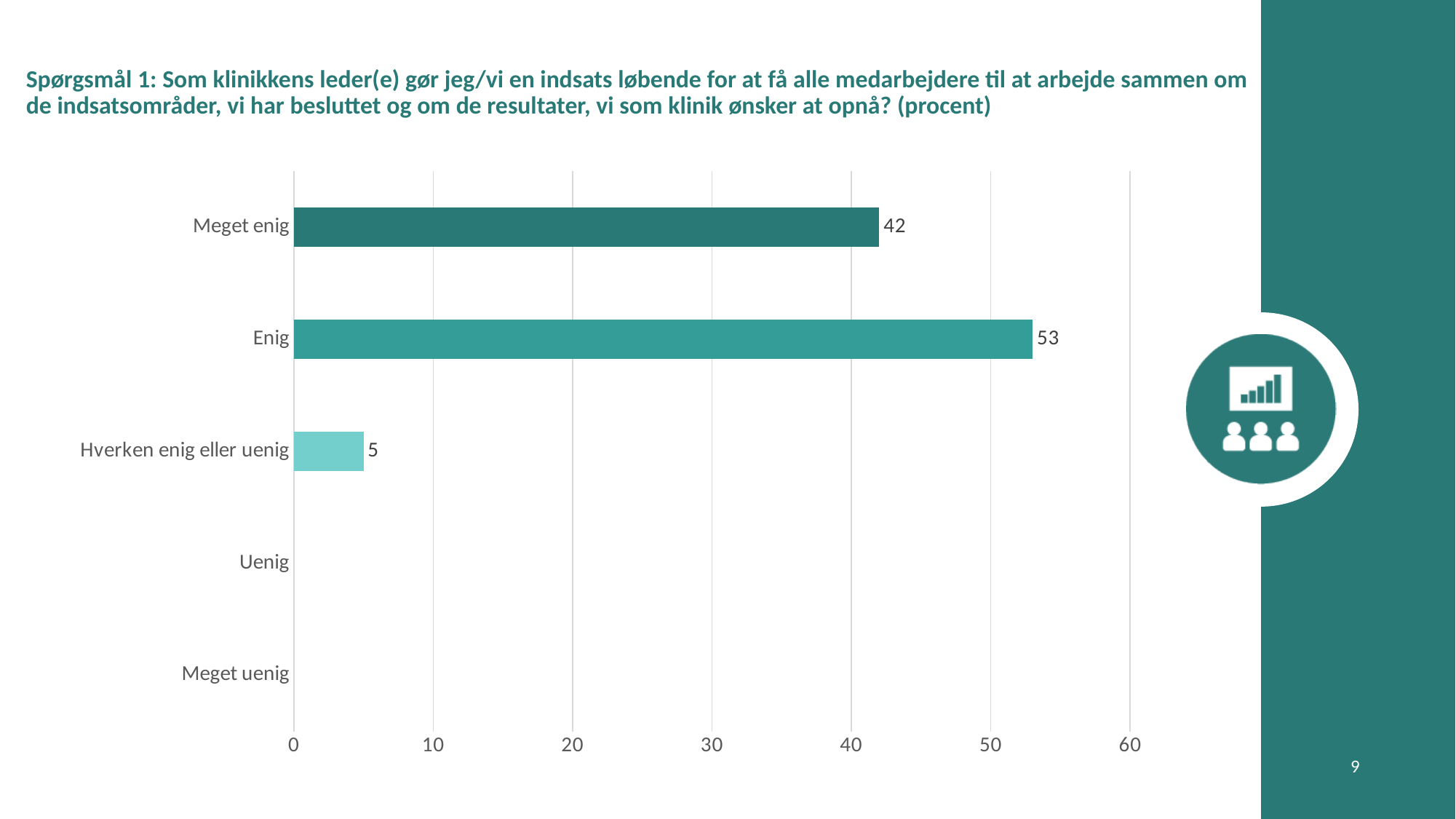
What is the value for Hverken enig eller uenig? 5 What is the difference between the values for Meget enig and Hverken enig eller uenig? 37 How many categories are listed on the vertical axis? 5 Is the value for Enig greater or less than 50? greater Is the value for Meget enig greater or less than 40? greater Which category has the highest value? Enig What is the value for Meget enig? 42 What kind of chart is shown on the slide? bar chart What is the difference between the values for Enig and Meget enig? 11 What is the highest value shown on the horizontal axis? 60 Which is larger, the value for Meget enig or the value for Enig? Enig What is the value for Enig? 53